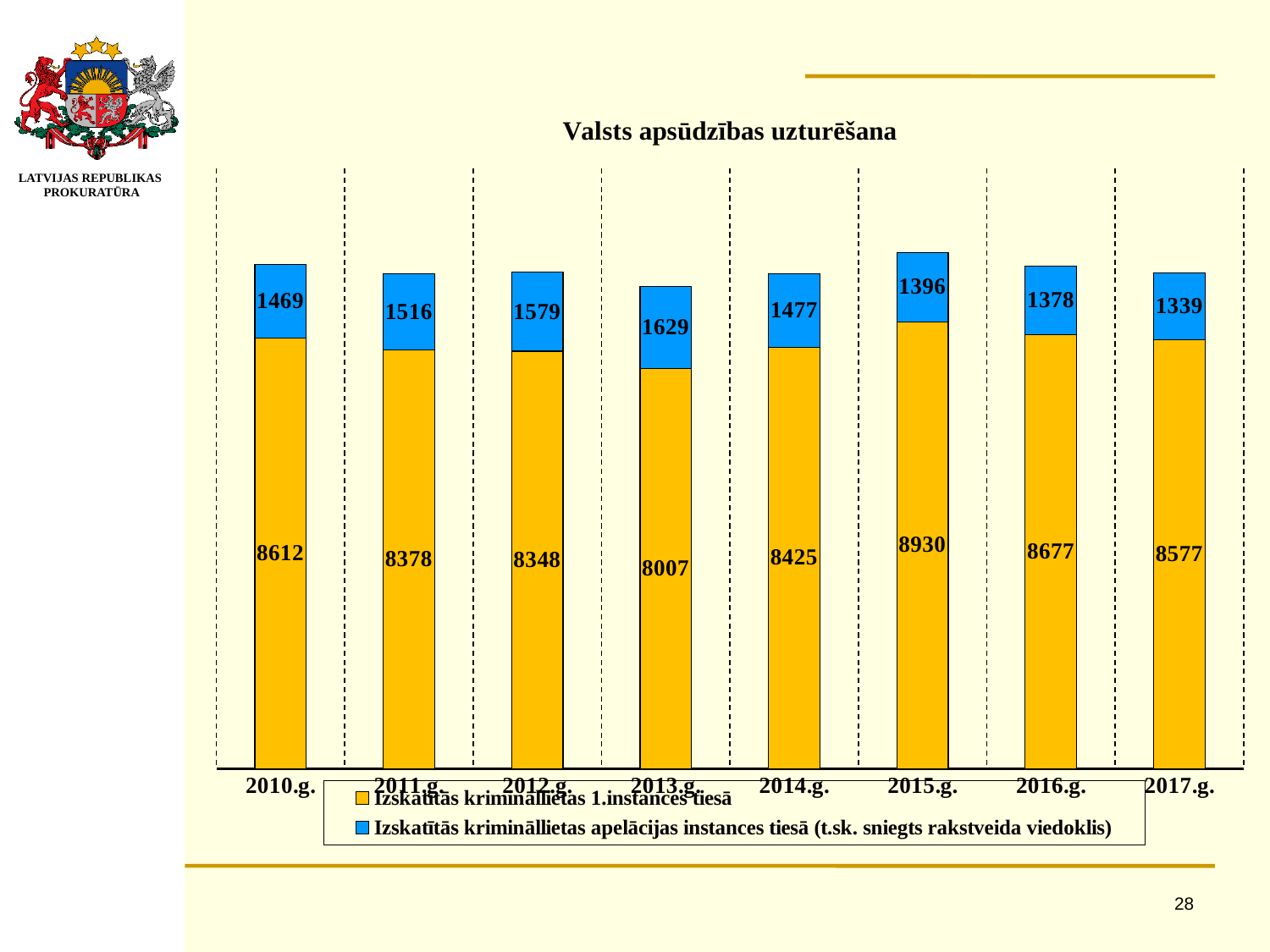
Is the apelācijas instances tiesā value larger in 2012.g. or in 2016.g.? 2012.g. What is the value for apelācijas instances tiesā (blue series) in 2013.g.? 1629 What is the total of the stacked bar for 2010.g.? 10081 How many years are shown on the x axis? 8 Which year has the highest value for 1.instances tiesā (yellow series)? 2015.g. What is the value for 1.instances tiesā (yellow series) in 2015.g.? 8930 How many series does the legend list? 2 Which year has the lowest value for apelācijas instances tiesā (blue series)? 2017.g. Which year has the lowest value for 1.instances tiesā (yellow series)? 2013.g. What kind of chart is shown on the slide? Stacked bar chart What is the value for 1.instances tiesā (yellow series) in 2010.g.? 8612 What is the difference between the 1.instances tiesā values for 2015.g. and 2013.g.? 923